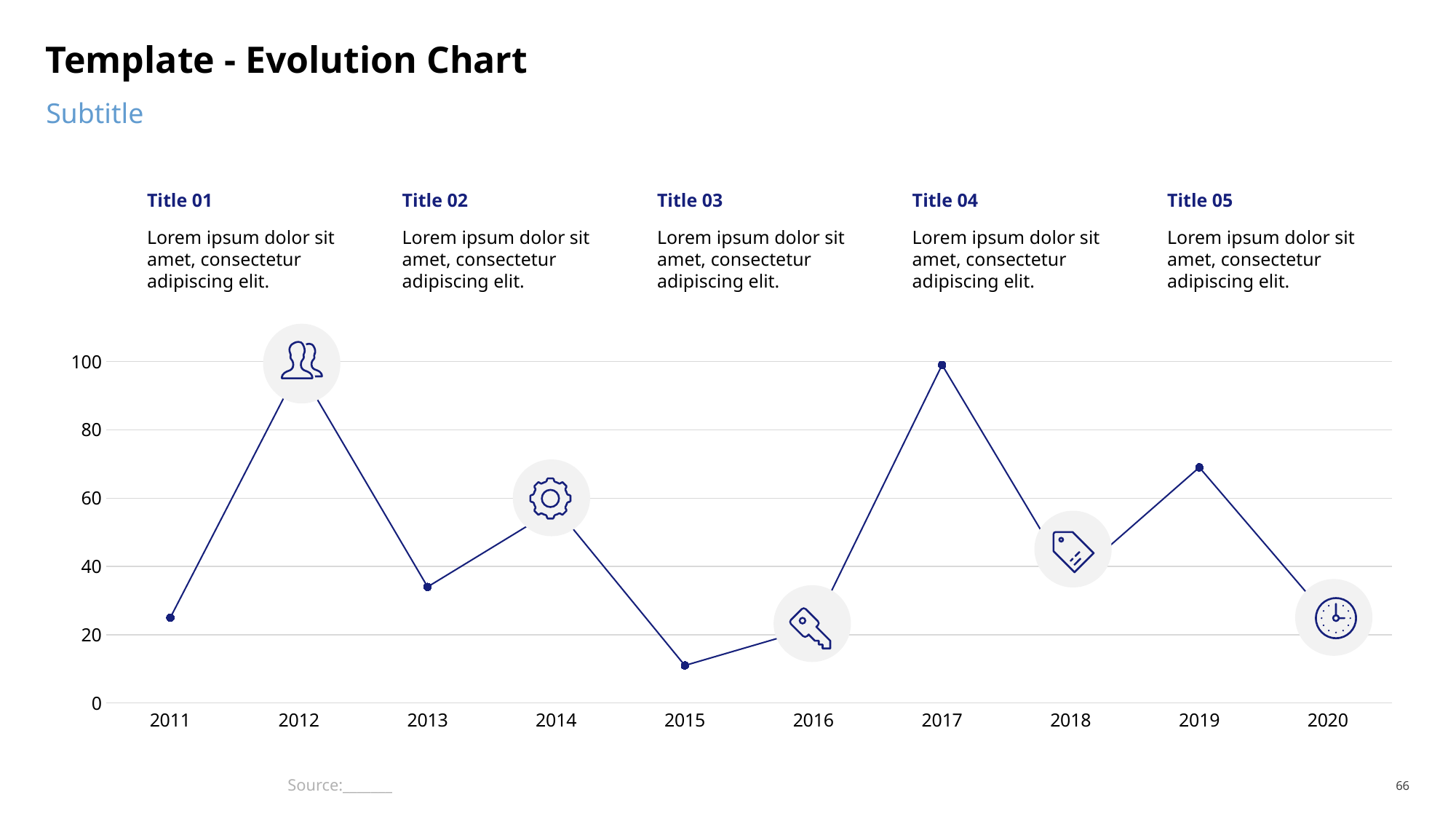
Which year has the larger value, 2011 or 2017? 2017 Is the value for 2013 greater or less than 40? less Is the value for 2019 greater or less than 60? greater Which year has the larger value, 2013 or 2019? 2019 Is the value for 2017 greater or less than 80? greater Does the value rise or fall from 2011 to 2012? rise What kind of chart is shown on the slide? line chart Does the value rise or fall from 2017 to 2018? fall Which year has the lowest value on the chart? 2015 How many years are plotted along the x axis of the chart? 10